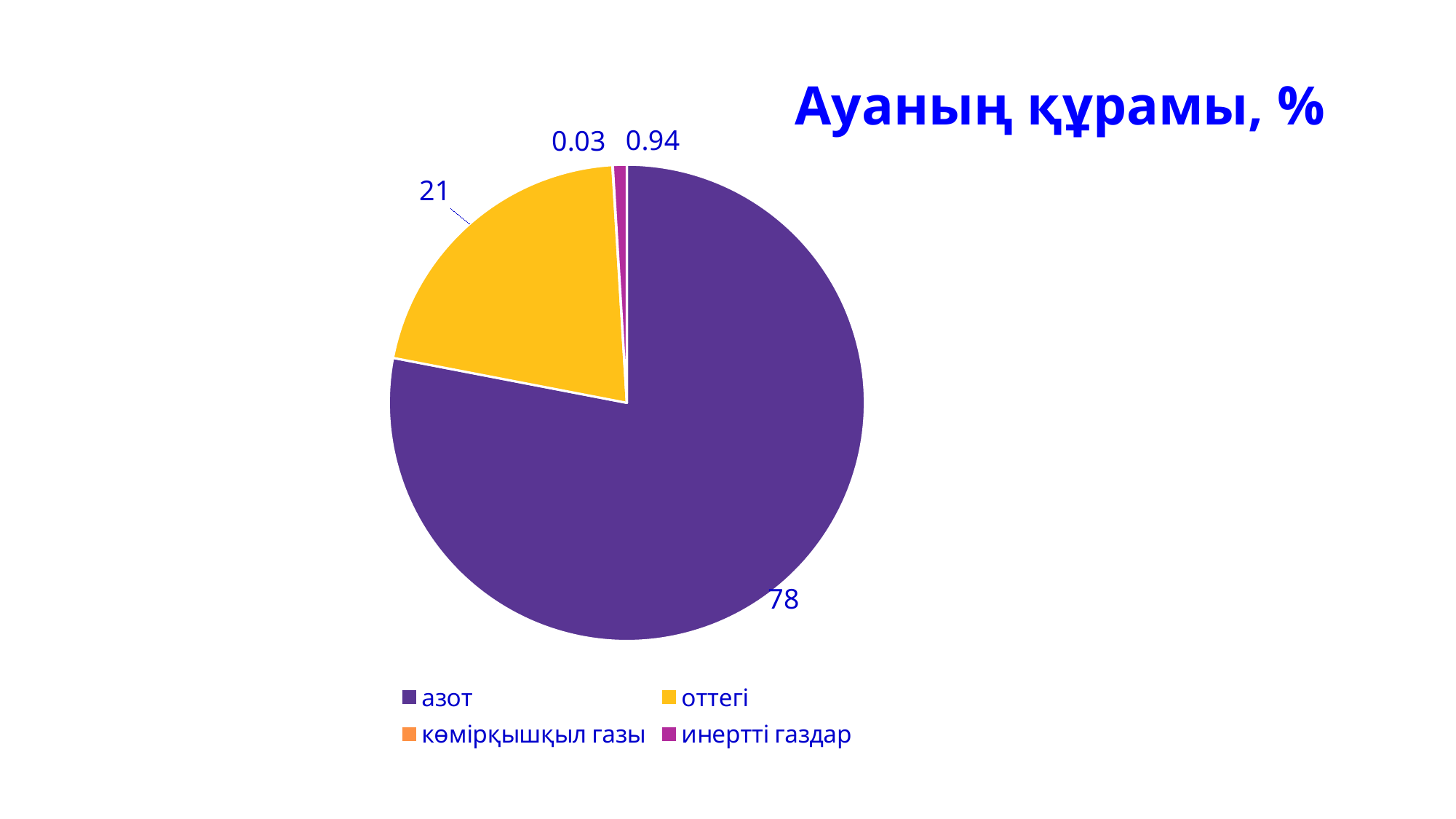
What is the difference between the values for азот and оттегі? 57 Which category has the smallest slice in the pie chart? көмірқышқыл газы How many categories does the pie chart show? 4 What is the value shown for көмірқышқыл газы in the pie chart? 0.03 Which category has the largest slice in the pie chart? азот Which is larger, the value for оттегі or the value for инертті газдар? оттегі What is the value shown for оттегі in the pie chart? 21 What is the title of the chart? Ауаның құрамы, % What is the value shown for инертті газдар in the pie chart? 0.94 What kind of chart is shown on the slide? pie chart What is the value shown for азот in the pie chart? 78 What is the difference between the values for инертті газдар and көмірқышқыл газы? 0.91